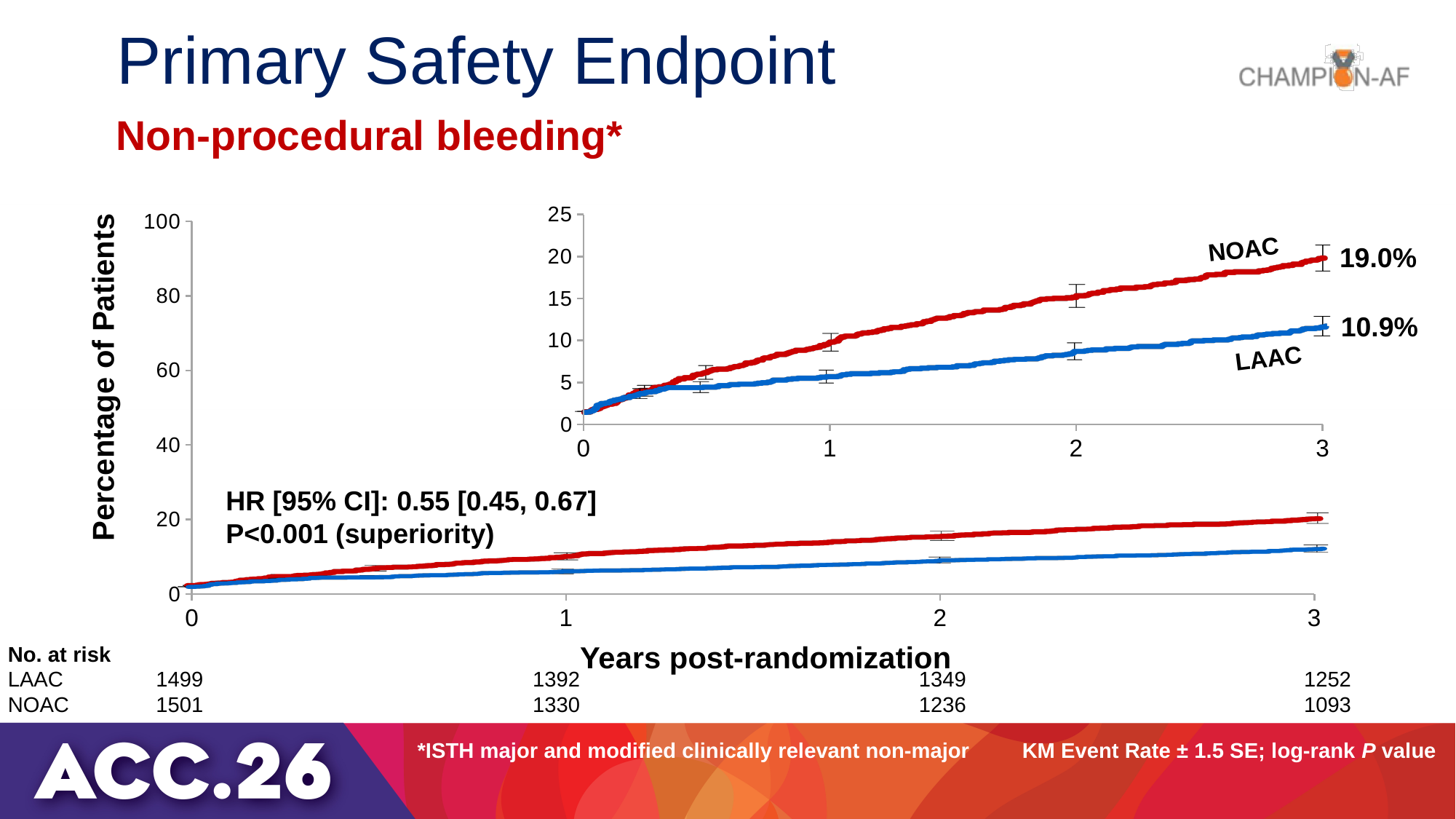
What kind of chart is shown on the slide? Line chart What is the event rate for NOAC at 3 years, as labelled on the inset chart? 19.0% What is the event rate for LAAC at 3 years, as labelled on the inset chart? 10.9% In the inset chart, is the value for NOAC at year 2 greater or less than 10? greater What is the difference between the NOAC and LAAC event rates at 3 years? 8.1% Which group has the higher non-procedural bleeding rate at 3 years, NOAC or LAAC? NOAC What colour is the NOAC line in the chart? Red Do the event rate curves rise or fall over the years post-randomization? Rise How many series (treatment groups) are plotted in the chart? 2 How many NOAC patients were at risk at year 0? 1501 In the inset chart, is the value for LAAC at year 2 greater or less than 10? less How many LAAC patients were at risk at 3 years? 1252